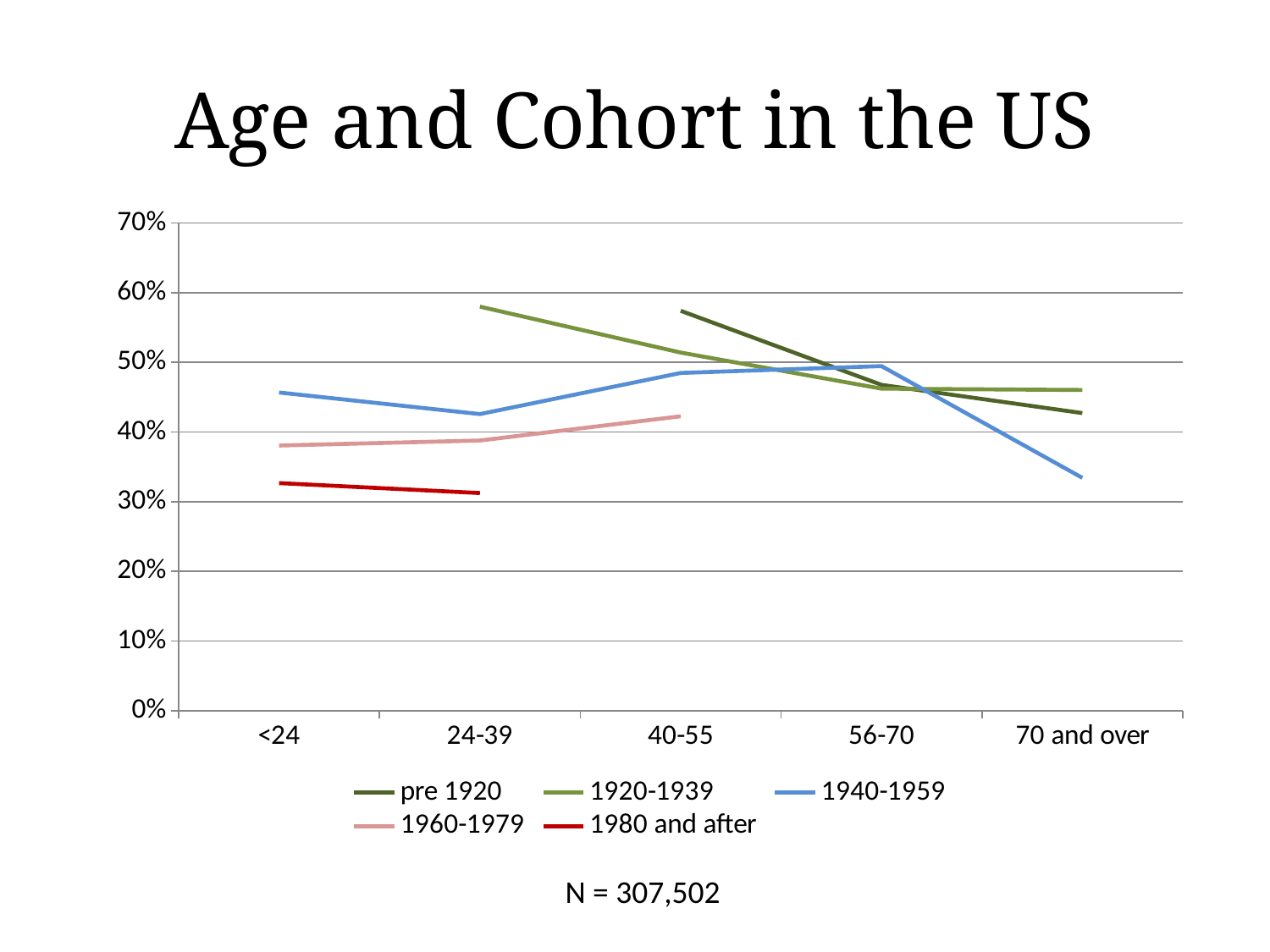
What sample size (N) is stated below the chart? N = 307,502 Is the value for the 1980 and after cohort at <24 greater or less than 40%? less What kind of chart is shown on the slide? line chart Is the value for the 1920-1939 cohort at 24-39 greater or less than 50%? greater Does the 1960-1979 line rise or fall from <24 to 40-55? rise Is the value for the 1960-1979 cohort at 40-55 greater or less than 50%? less Does the 1920-1939 line rise or fall from 24-39 to 70 and over? fall How many series does the legend list? 5 How many age categories are shown on the x axis? 5 What is the title of the chart? Age and Cohort in the US